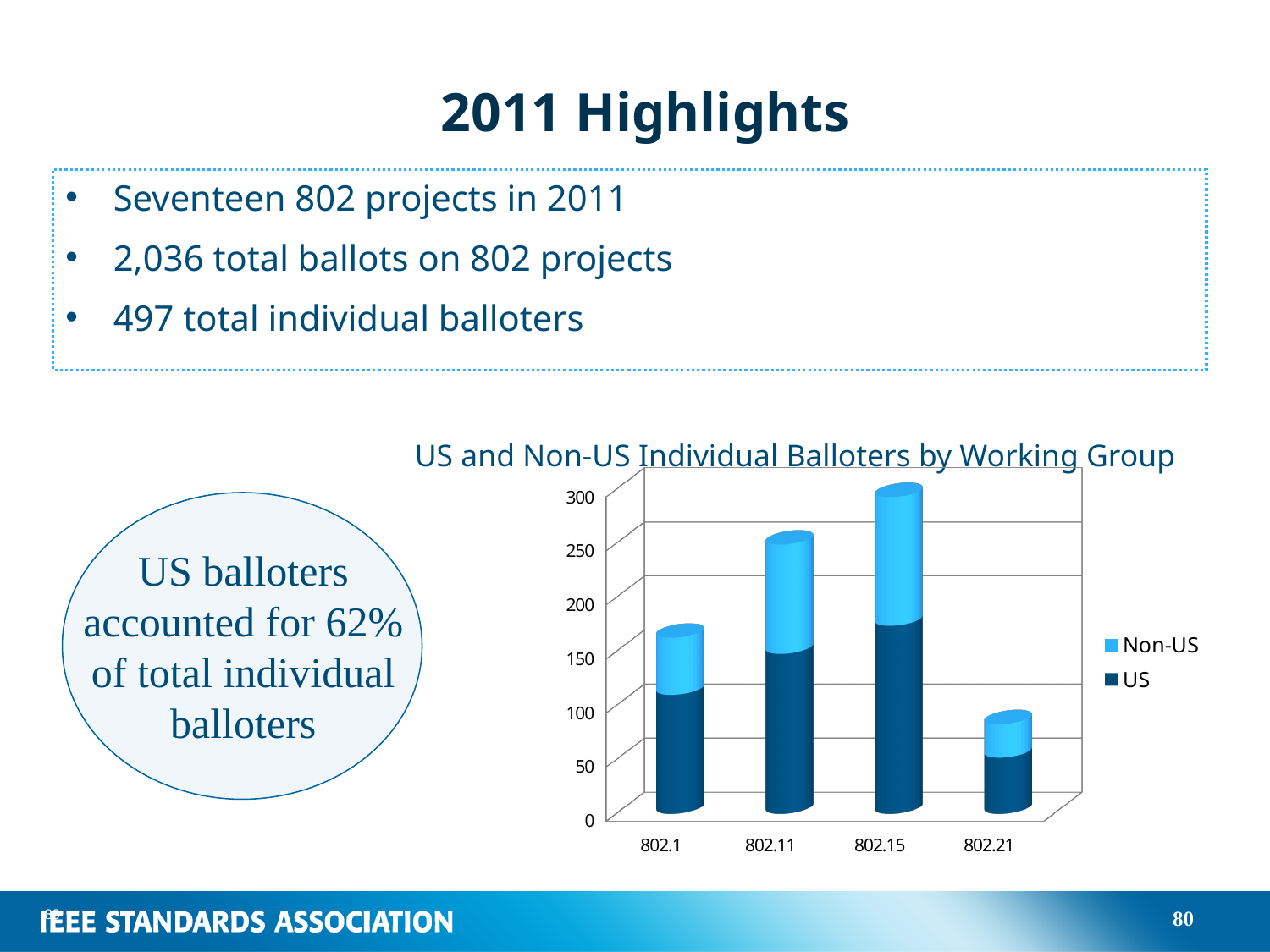
Which working group has the tallest stacked bar in the chart? 802.15 How many series does the chart legend list? 2 Is the total bar height for 802.11 greater or less than 200? greater Is the total bar height for 802.21 greater or less than 100? less How many working groups are shown on the x axis of the chart? 4 What is the title of the chart? US and Non-US Individual Balloters by Working Group Which working group has the shortest stacked bar in the chart? 802.21 What kind of chart is shown on the slide? Stacked bar chart Which has the taller stacked bar, 802.1 or 802.11? 802.11 Which working group has the larger US segment, 802.15 or 802.21? 802.15 Is the total bar height for 802.15 greater or less than 250? greater Which series is shown in the darker blue colour in the chart? US